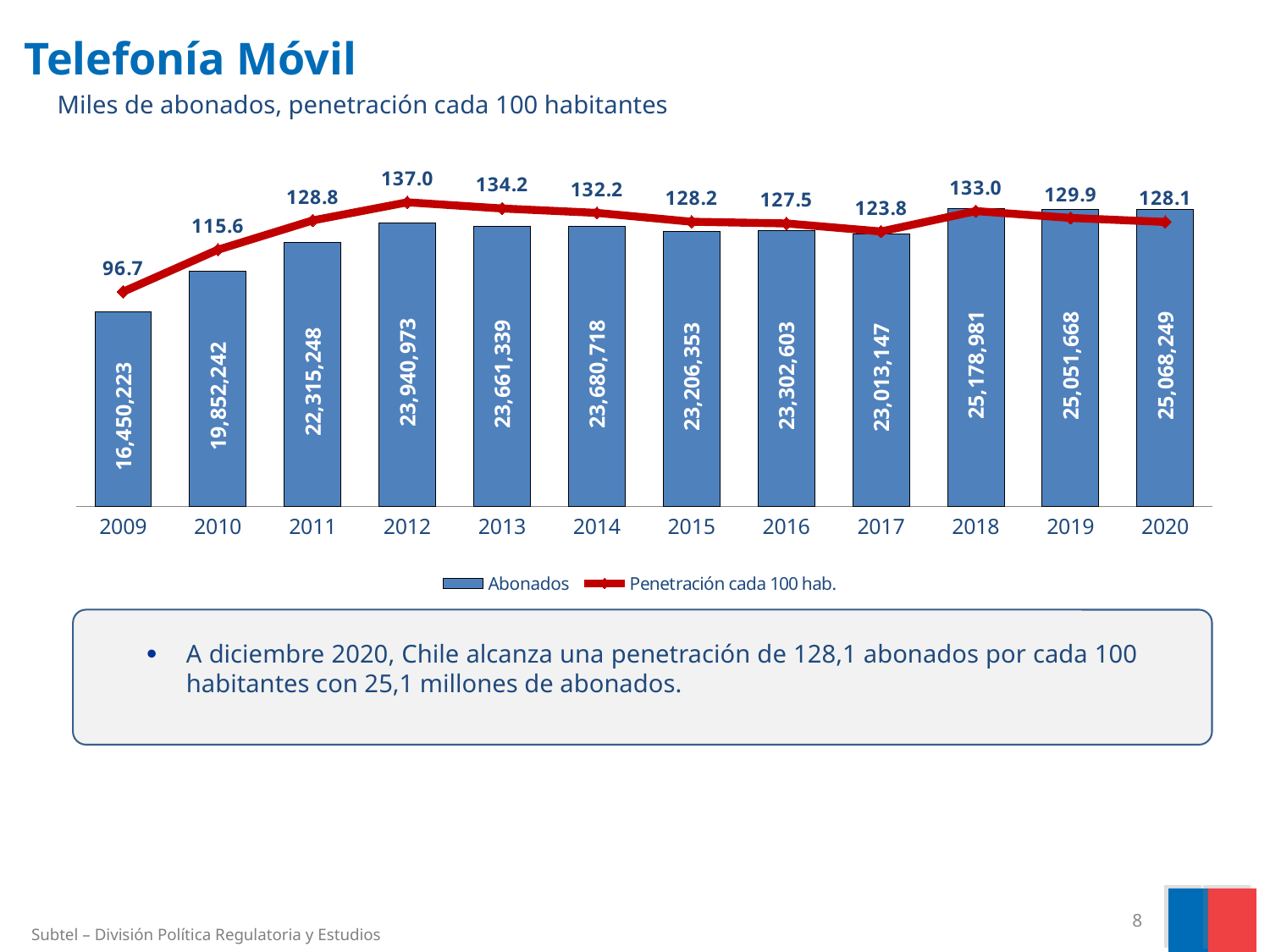
What is the difference in Abonados between 2020 and 2009? 8,618,026 What is the difference in Penetración cada 100 hab. between 2012 and 2020? 8.9 What is the Abonados value for 2020? 25,068,249 Which year has the highest Abonados value? 2018 What is the Penetración cada 100 hab. value for 2012? 137.0 Does the Penetración cada 100 hab. line rise or fall from 2009 to 2012? rise What is the Abonados value for 2009? 16,450,223 Which year has the lowest Penetración cada 100 hab. value? 2009 How many years are shown on the x axis of the chart? 12 How many series does the legend list? 2 Which year has a larger Abonados value, 2017 or 2018? 2018 Which year has the highest Penetración cada 100 hab. value? 2012